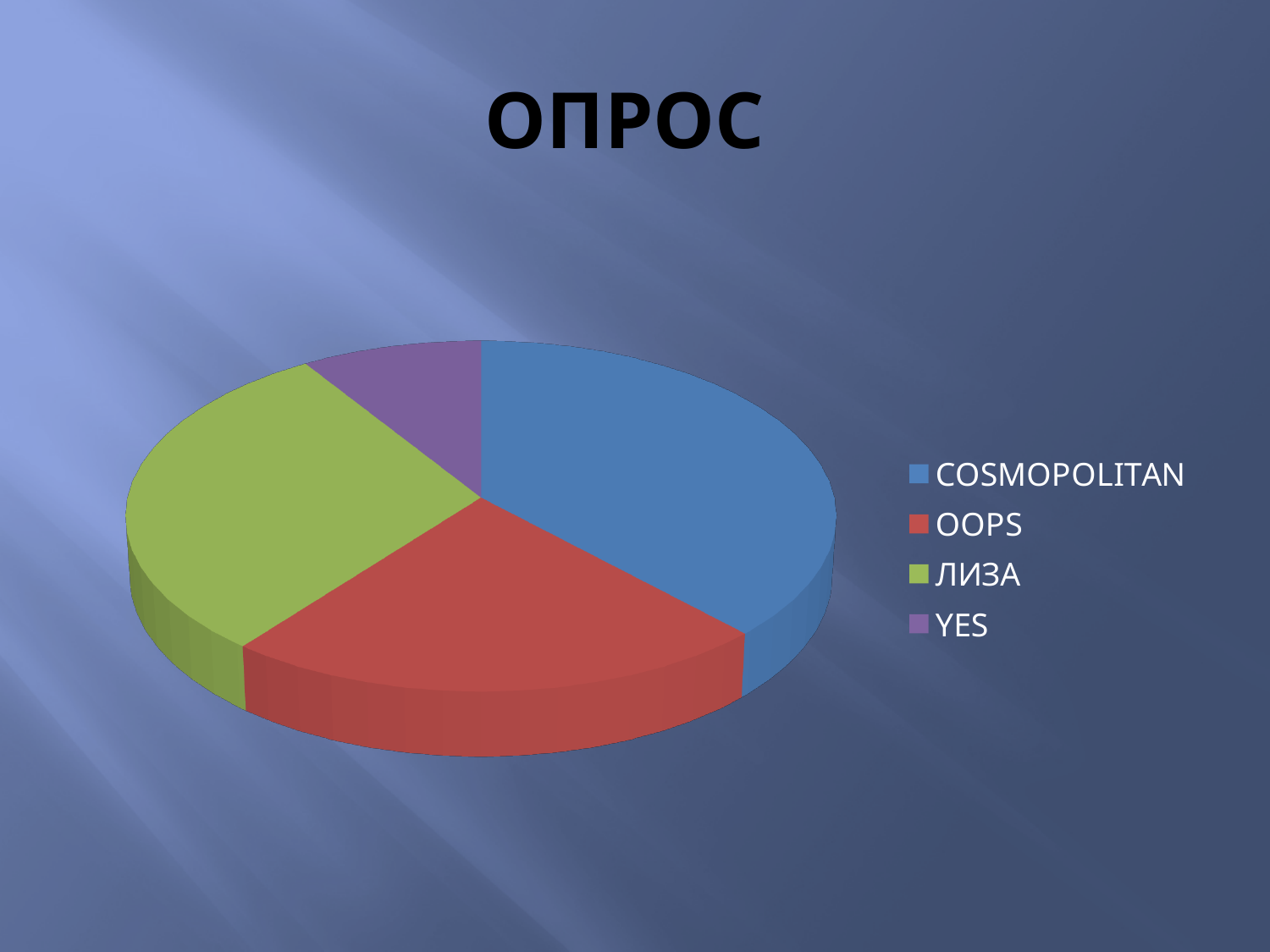
Which slice is larger, ЛИЗА or YES? ЛИЗА What is the title of the chart? ОПРОС Which slice is larger, OOPS or YES? OOPS Which colour represents ЛИЗА in the pie chart? green How many slices does the pie chart have? 4 What kind of chart is shown on the slide? pie chart Which slice is larger, COSMOPOLITAN or ЛИЗА? COSMOPOLITAN Which category has the smallest slice of the pie? YES How many entries does the legend list? 4 Which category has the largest slice of the pie? COSMOPOLITAN